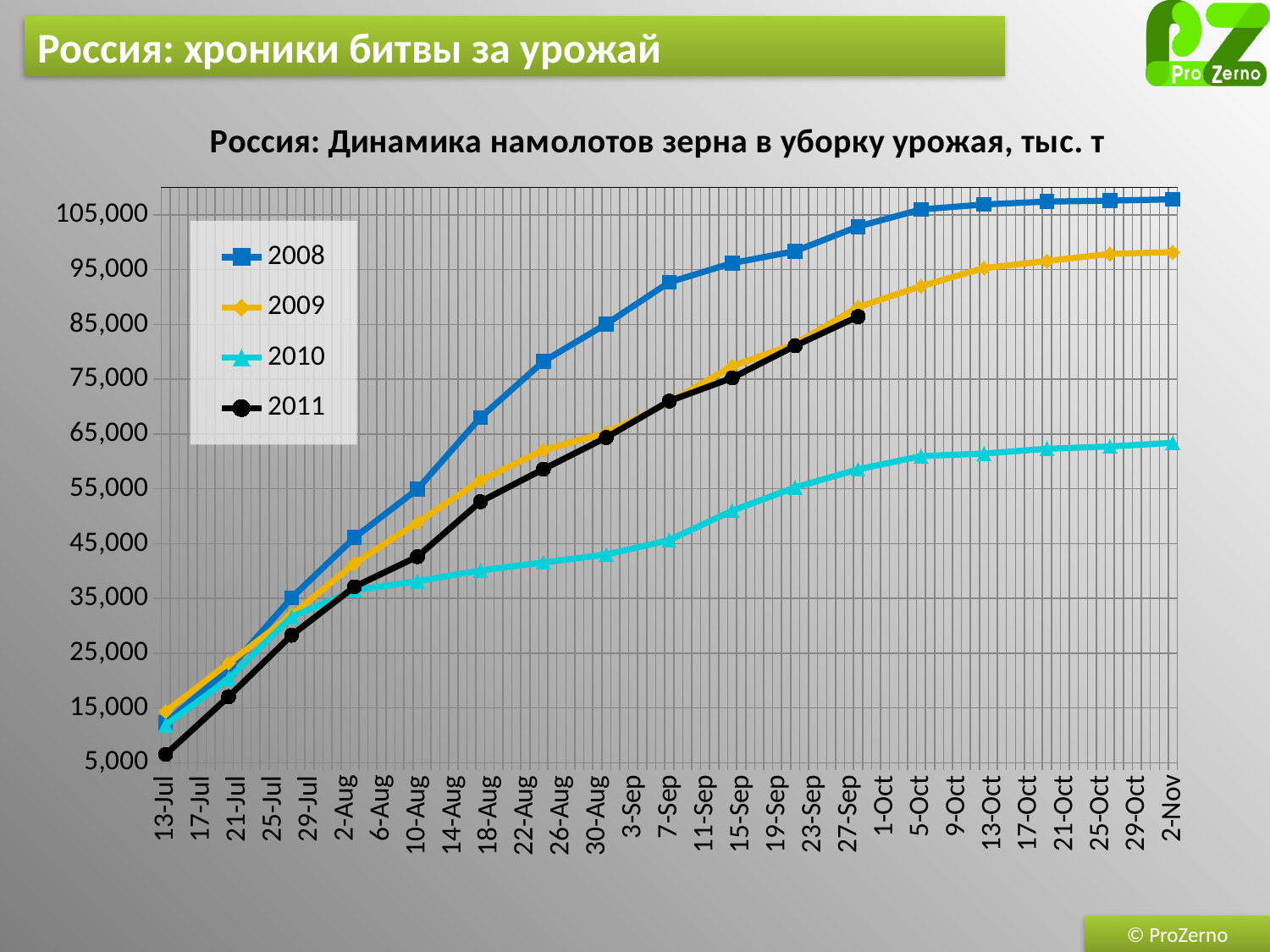
How many series does the legend list? 4 Is the value for the 2010 series at 2-Nov greater or less than 65,000? less What kind of chart is shown on the slide? line chart Which series has the highest value at 2-Nov? 2008 Is the value for the 2008 series at 2-Nov greater or less than 105,000? greater At 30-Aug, which series has the larger value, 2008 or 2009? 2008 Which series has the lowest value at 13-Jul? 2011 What are the series names listed in the legend? 2008, 2009, 2010, 2011 Do the values of the 2008 series rise or fall along the x axis? rise Is the value for the 2011 series at 27-Sep greater or less than 75,000? greater Which series has the lowest value at 2-Nov? 2010 What is the title of the chart? Россия: Динамика намолотов зерна в уборку урожая, тыс. т